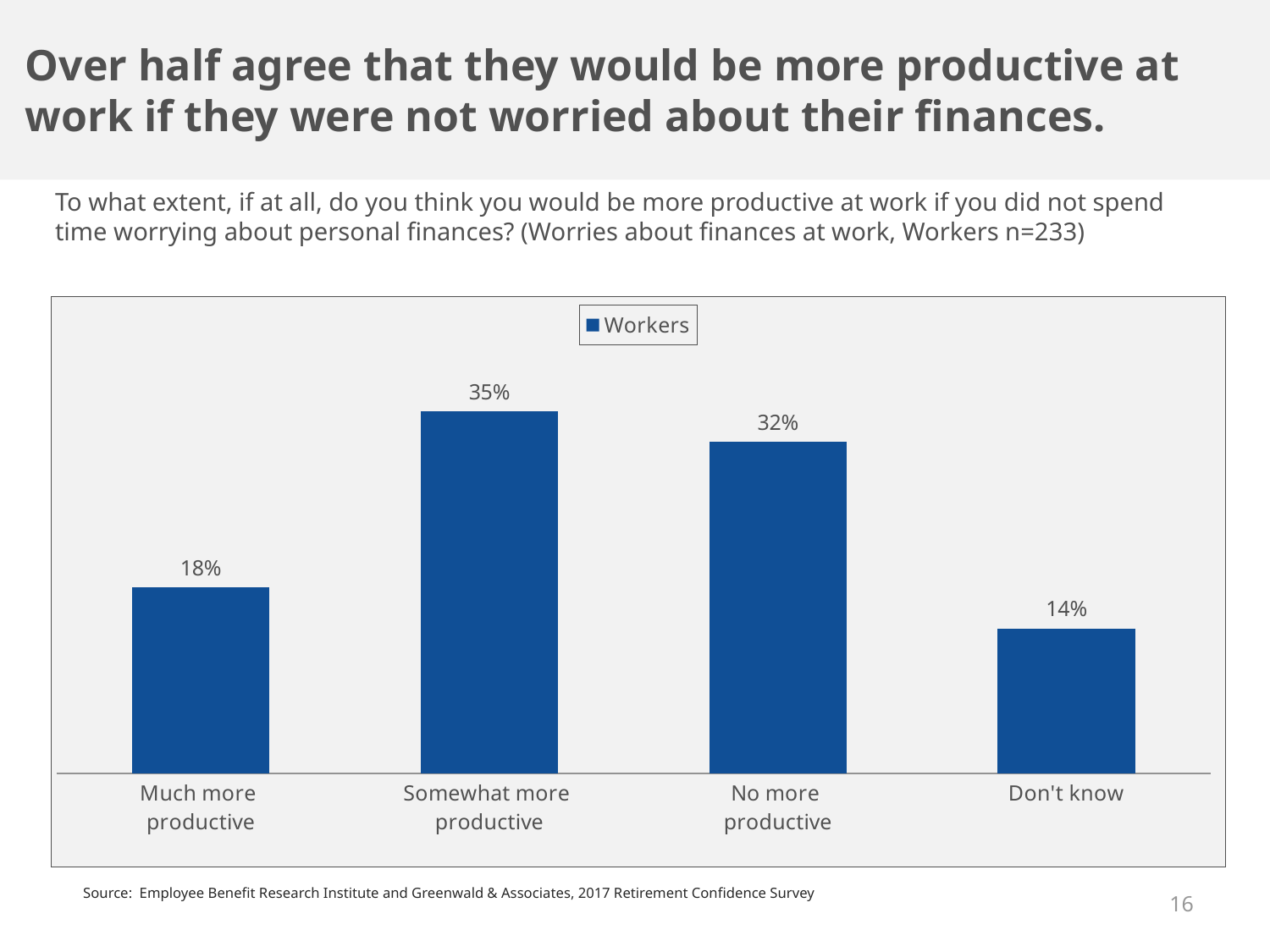
What percentage of workers said they would be much more productive? 18% What percentage of workers said they would be somewhat more productive? 35% What percentage of workers answered 'Don't know'? 14% What is the difference in percentage points between 'No more productive' and 'Don't know'? 18 What percentage of workers said they would be no more productive? 32% Which response category has the lowest percentage? Don't know What kind of chart is shown on the slide? Bar chart How many series does the legend list? 1 What is the difference in percentage points between 'Somewhat more productive' and 'Much more productive'? 17 How many response categories are shown on the chart? 4 Which is larger: the percentage for 'Much more productive' or for 'No more productive'? No more productive Which response category has the highest percentage? Somewhat more productive